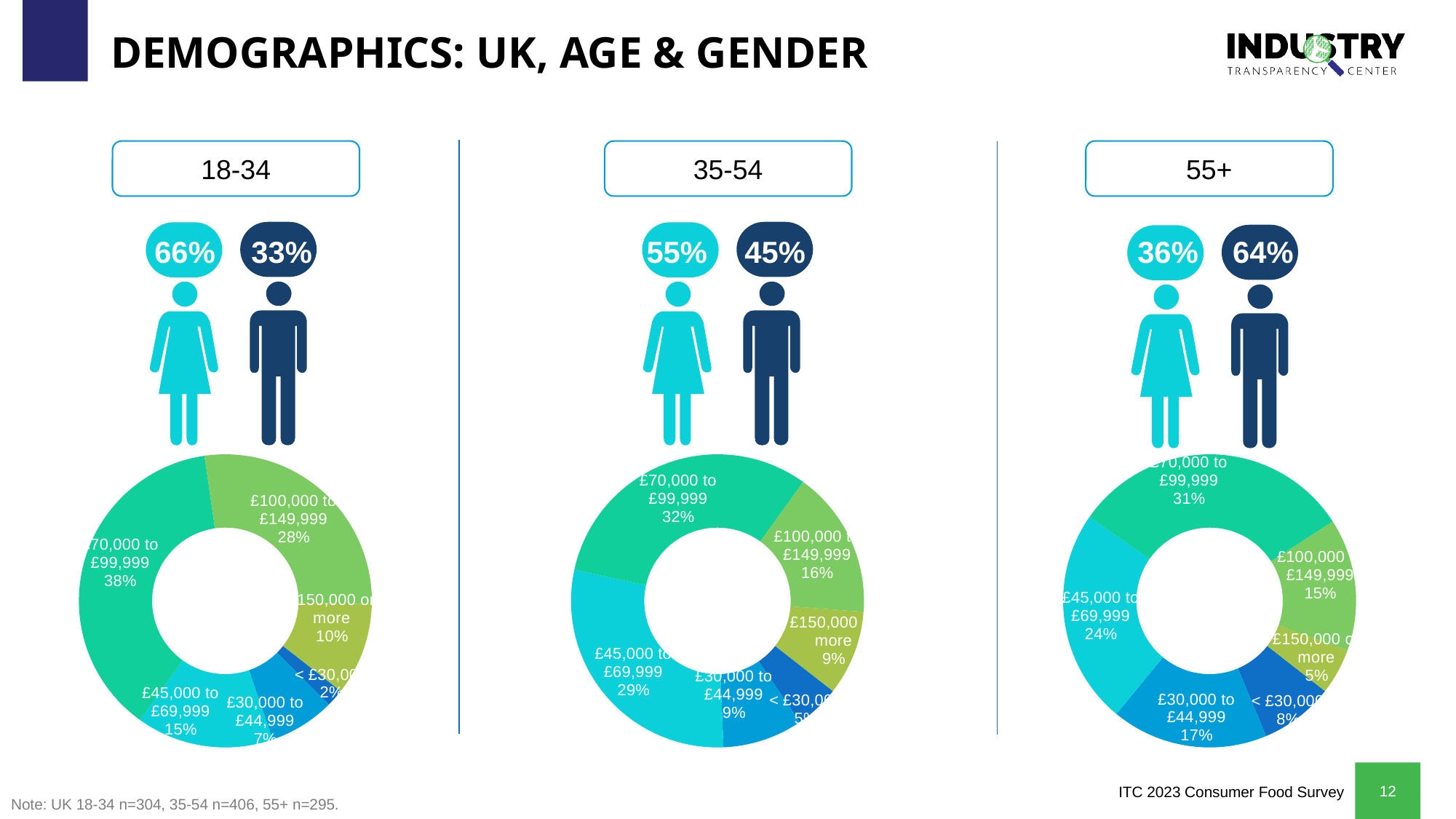
In the 18-34 donut chart, which income band has the largest share? £70,000 to £99,999 In the 18-34 donut chart, what share of respondents earn £70,000 to £99,999? 38% In the 35-54 donut chart, what share of respondents earn £45,000 to £69,999? 29% In the 35-54 donut chart, which income band has the largest share? £70,000 to £99,999 In the 18-34 donut chart, what is the difference between the £100,000 to £149,999 share and the £150,000 or more share? 18 percentage points In the 55+ age group, what percentage of respondents are male? 64% How many donut charts are shown on the slide? 3 In the 55+ donut chart, which is larger: the £45,000 to £69,999 share or the £100,000 to £149,999 share? £45,000 to £69,999 In the 55+ donut chart, what share of respondents earn £30,000 to £44,999? 17% In the 55+ donut chart, which income band has the smallest share? £150,000 or more How many income bands are shown in the 35-54 donut chart? 6 What type of chart is used to show the income distribution for each age group? Donut (pie) chart